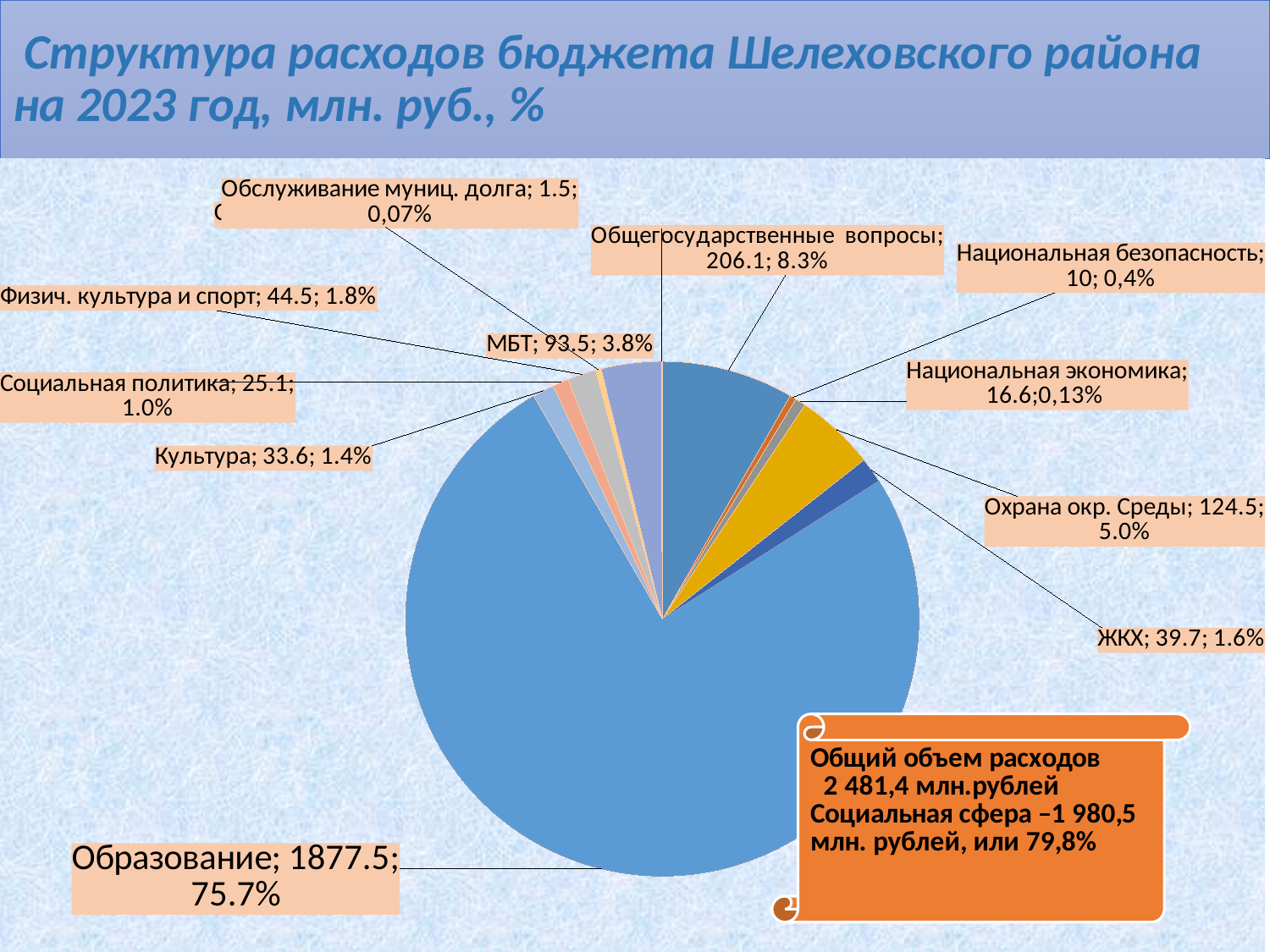
Which category has the largest slice of the pie? Образование Which is larger, the value for Физич. культура и спорт or the value for ЖКХ? Физич. культура и спорт How many categories are shown in the pie chart? 12 What is the value for МБТ? 93.5 What is the value for Охрана окр. Среды? 124.5 Which category has the smallest value in the pie chart? Обслуживание муниц. долга What share of the pie does Образование represent? 75.7% What is the difference between the values for Образование and Общегосударственные вопросы? 1671.4 What type of chart is shown on the slide? pie chart What is the value for Общегосударственные вопросы? 206.1 What is the title of the chart on the slide? Структура расходов бюджета Шелеховского района на 2023 год, млн. руб., % What is the value for Образование in the pie chart? 1877.5